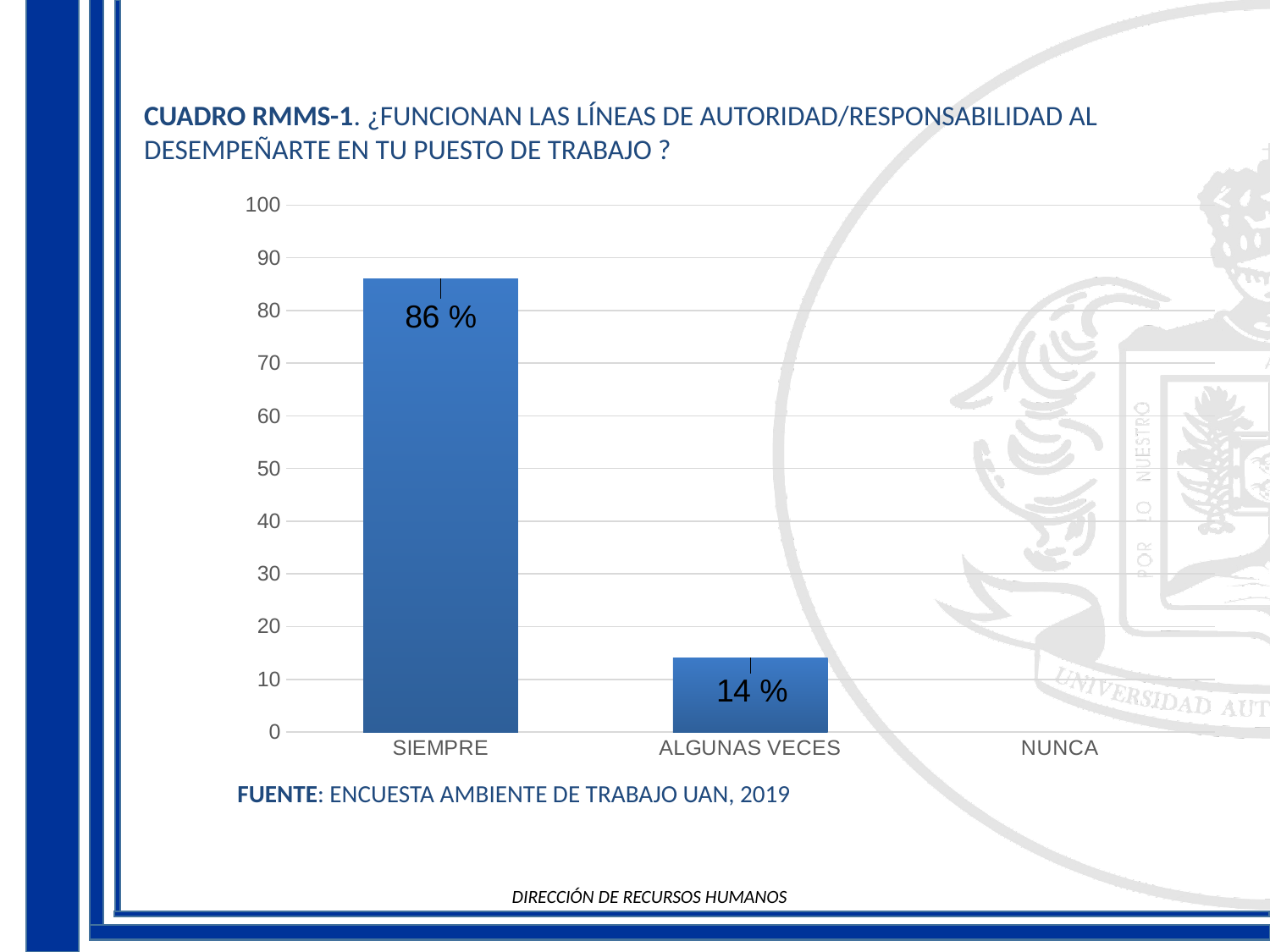
What is the value for ALGUNAS VECES? 14 % What source is cited below the chart? ENCUESTA AMBIENTE DE TRABAJO UAN, 2019 What kind of chart is shown on the slide? bar chart What is the difference between the values for SIEMPRE and ALGUNAS VECES? 72 % What is the highest value shown on the y axis? 100 Which category has the highest value? SIEMPRE What is the value for SIEMPRE? 86 % Which is larger, the value for SIEMPRE or the value for ALGUNAS VECES? SIEMPRE Is the value for ALGUNAS VECES greater or less than 20? less Is the value for SIEMPRE greater or less than 80? greater Do the values rise or fall from SIEMPRE to ALGUNAS VECES? fall How many categories are shown on the x axis? 3